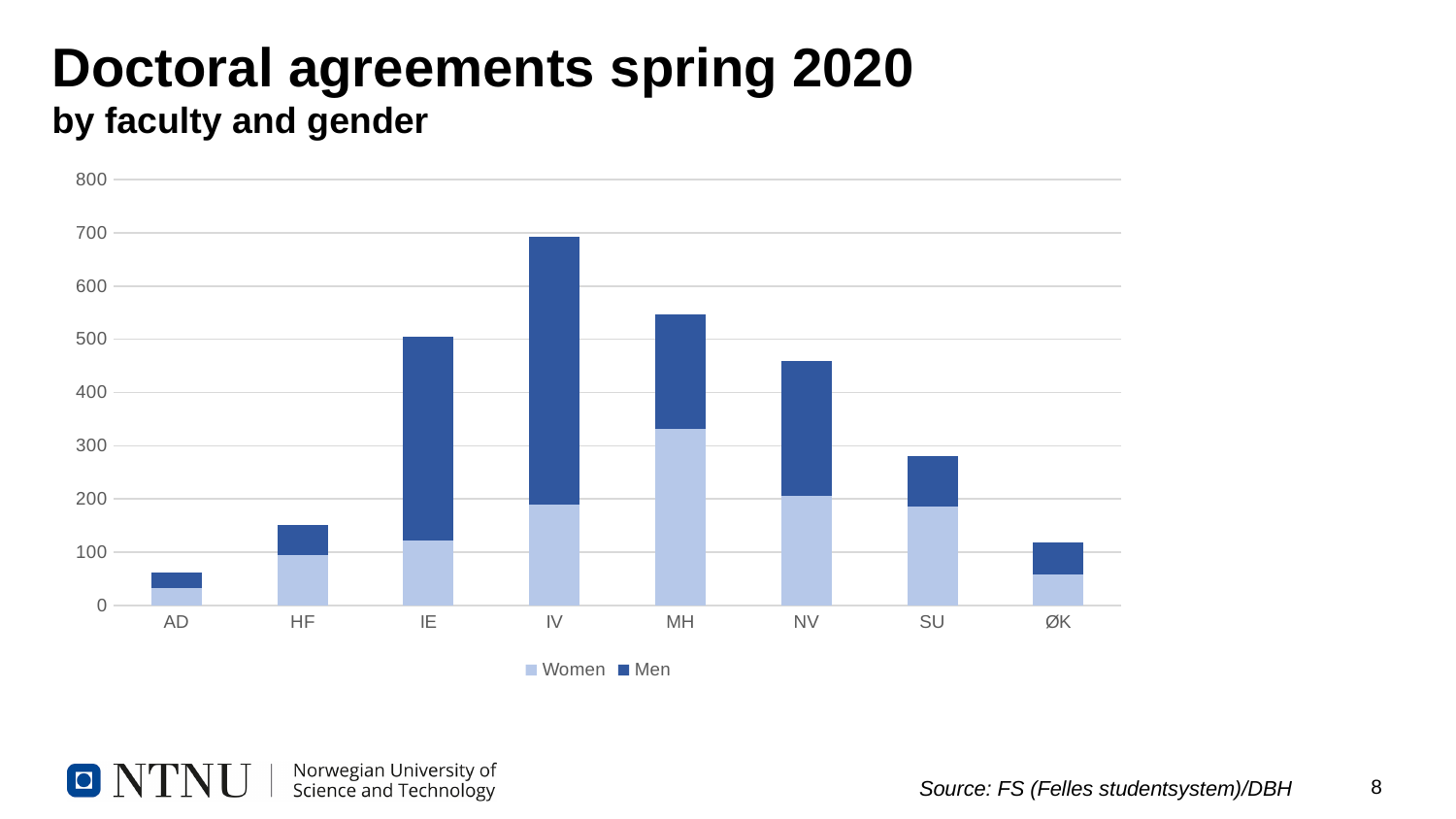
Is the total value for IV greater or less than 600? greater How many series does the legend list? 2 Which faculty has the lowest total number of doctoral agreements? AD What kind of chart is shown on the slide? stacked bar chart Which faculty has the highest total number of doctoral agreements? IV Is the total value for NV greater or less than 400? greater How many faculties are shown on the x axis? 8 Is the Women value for MH greater or less than 300? greater Which has the larger total number of doctoral agreements, MH or NV? MH Which faculty has the highest number of doctoral agreements for Women? MH What are the two series named in the legend? Women and Men